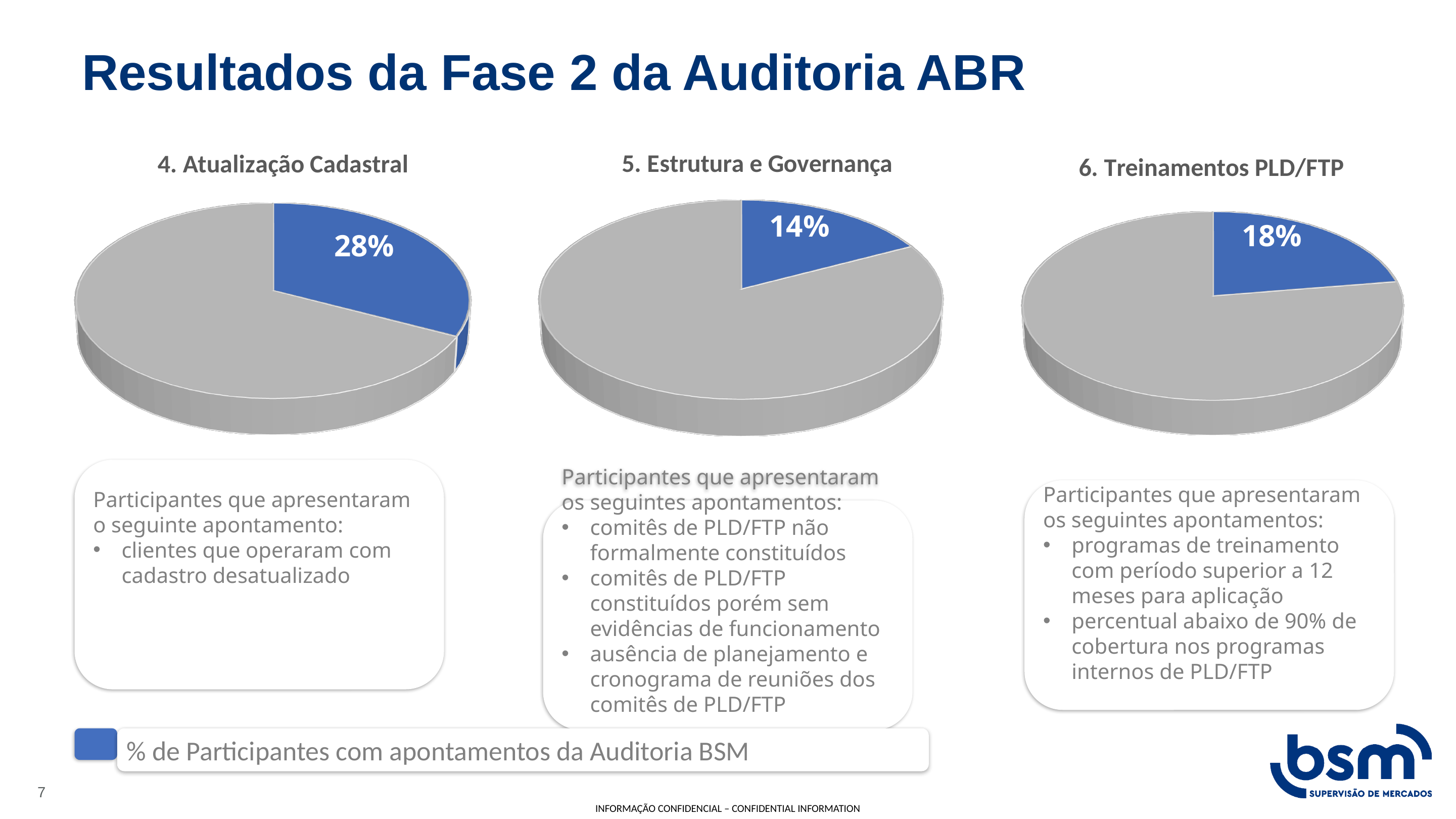
Which of the three pie charts shows the highest percentage of participants with findings? 4. Atualização Cadastral Which is larger: the blue slice in '6. Treinamentos PLD/FTP' or the blue slice in '4. Atualização Cadastral'? 4. Atualização Cadastral In the '5. Estrutura e Governança' chart, is the blue slice larger or smaller than the gray slice? Smaller In the '6. Treinamentos PLD/FTP' chart, what percentage is shown for the blue slice? 18% In the '4. Atualização Cadastral' chart, what percentage is shown for the blue slice? 28% How many pie charts are shown on the slide? 3 Which of the three pie charts shows the lowest percentage of participants with findings? 5. Estrutura e Governança What is the difference between the blue-slice percentage in '4. Atualização Cadastral' and in '5. Estrutura e Governança'? 14% In the '5. Estrutura e Governança' chart, what percentage is shown for the blue slice? 14% According to the legend at the bottom of the slide, what does the blue colour represent? % de Participantes com apontamentos da Auditoria BSM What kind of chart is used for '4. Atualização Cadastral'? Pie chart What is the difference between the blue-slice percentage in '6. Treinamentos PLD/FTP' and in '5. Estrutura e Governança'? 4%